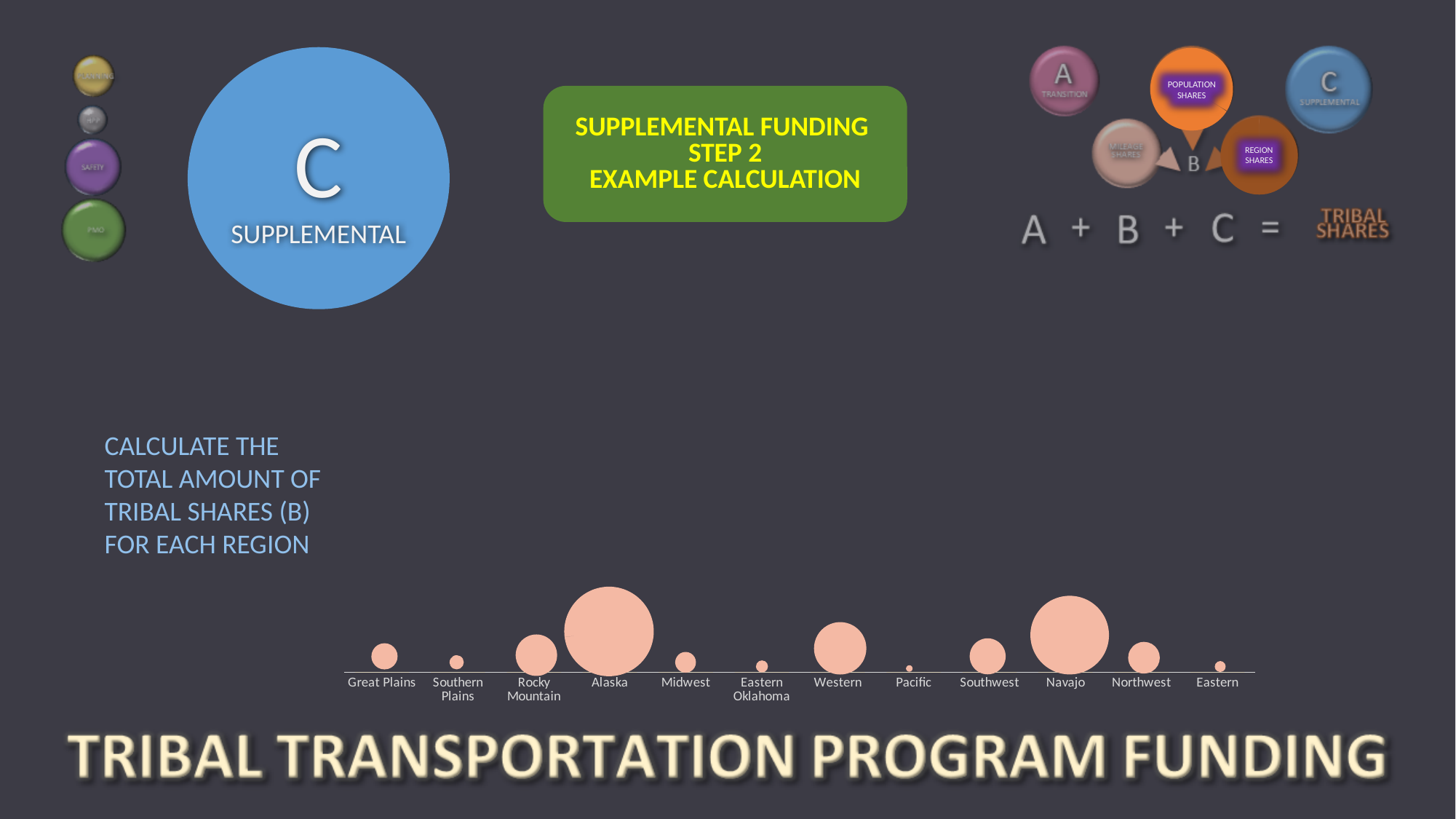
What kind of chart is shown at the bottom of the slide? Bubble chart Which region has the smallest bubble in the chart? Pacific Which region is plotted first (leftmost) in the bubble chart? Great Plains Which bubble is larger, Navajo or Northwest? Navajo Which bubble is larger, Western or Midwest? Western Which region is plotted last (rightmost) in the bubble chart? Eastern Which bubble is larger, Alaska or Great Plains? Alaska How many regions are plotted in the bubble chart? 12